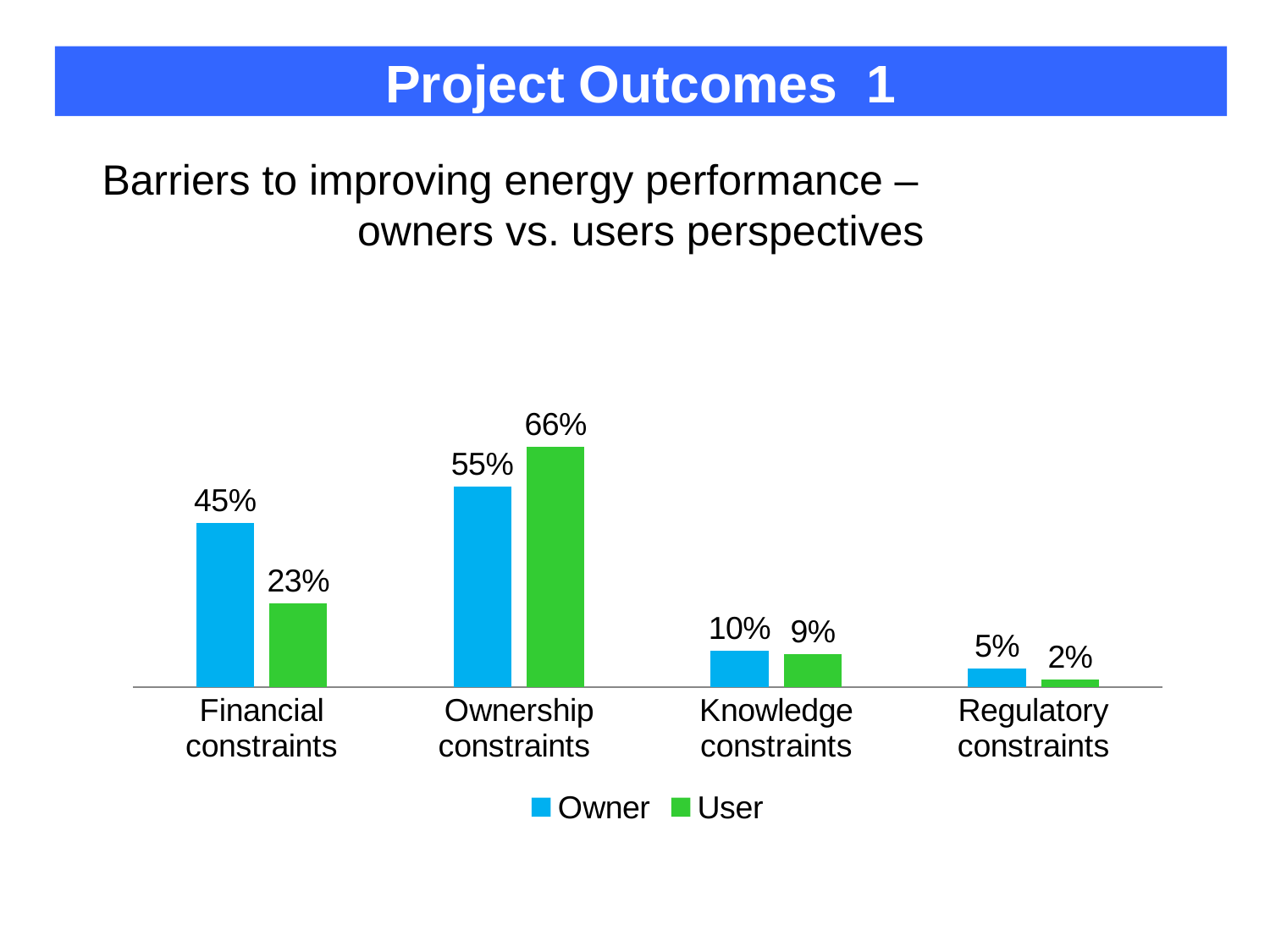
Which category has the lowest User value? Regulatory constraints What kind of chart is shown on the slide? Bar chart How many categories are shown on the x axis? 4 How many series does the legend list? 2 What is the User value for Ownership constraints? 66% For Financial constraints, which is larger, the Owner value or the User value? Owner What is the difference between the User and Owner values for Ownership constraints? 11% What is the difference between the Owner and User values for Financial constraints? 22% What is the User value for Regulatory constraints? 2% Which category has the highest Owner value? Ownership constraints What is the Owner value for Knowledge constraints? 10% What is the Owner value for Financial constraints? 45%